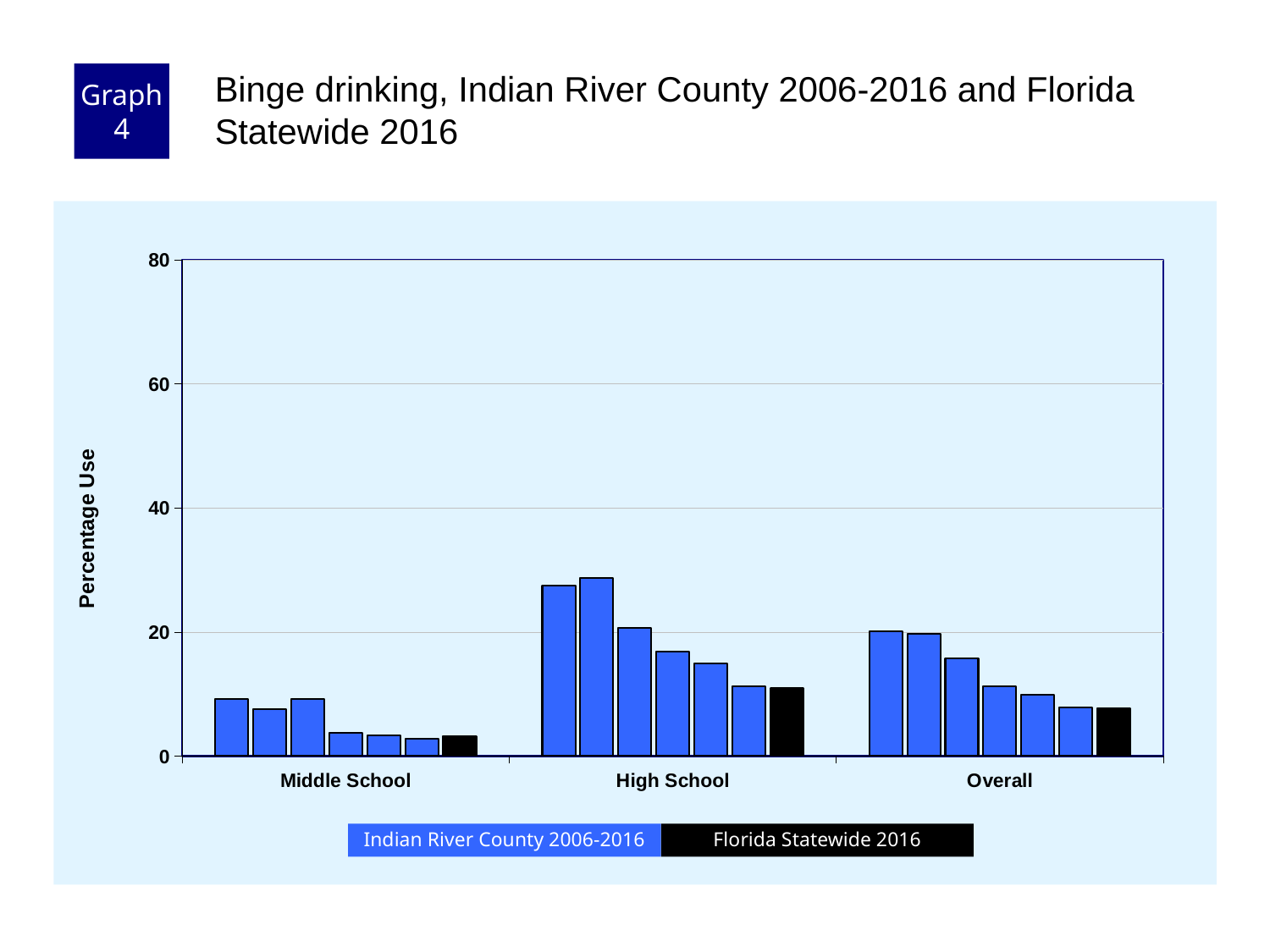
Is the Florida Statewide 2016 value for Middle School greater or less than 20? less What kind of chart is shown on the slide? bar chart Is the tallest Indian River County 2006-2016 bar for High School greater or less than 20? greater What colour are the Florida Statewide 2016 bars? black Which category has the shortest bars? Middle School How many categories are shown on the x axis? 3 Which category has the tallest bars? High School What is the label on the y axis? Percentage Use Is the Florida Statewide 2016 value for Overall greater or less than 20? less In the Overall group, do the Indian River County 2006-2016 bars rise or fall from left to right? fall How many series does the legend list? 2 Which is larger, the Florida Statewide 2016 value for High School or for Overall? High School